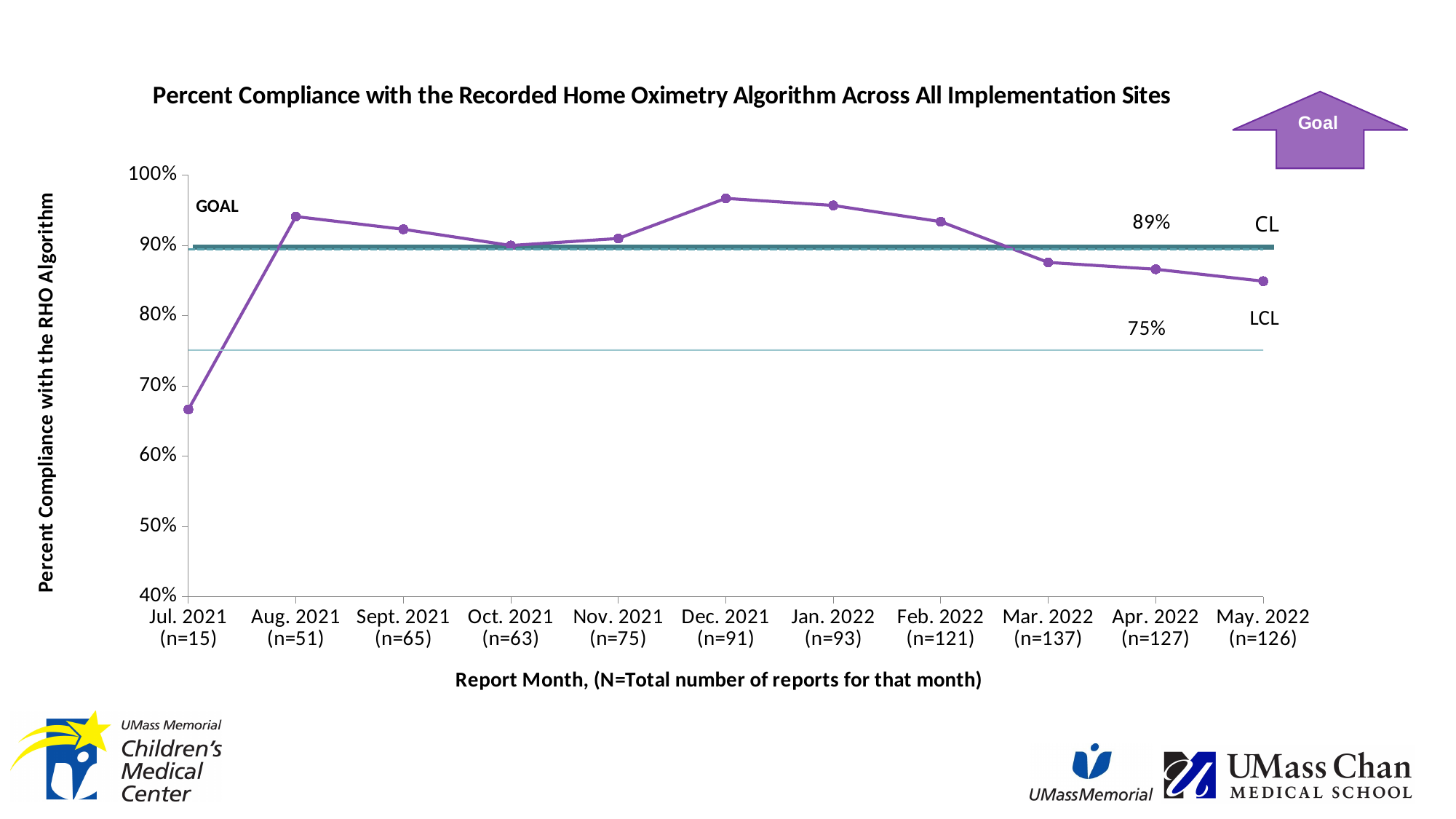
What is the value of the LCL line shown on the chart? 75% Is the value for Jul. 2021 greater or less than 70%? less Which is larger, the value for Dec. 2021 or the value for Mar. 2022? Dec. 2021 How many report months are plotted on the x axis? 11 Do the values rise or fall from Feb. 2022 to May 2022? fall Is the value for Aug. 2021 greater or less than 90%? greater What is the value of the CL line shown on the chart? 89% Is the value for Mar. 2022 greater or less than 80%? greater What kind of chart is shown on the slide? line chart Which report month has the lowest percent compliance? Jul. 2021 Which report month has the highest percent compliance? Dec. 2021